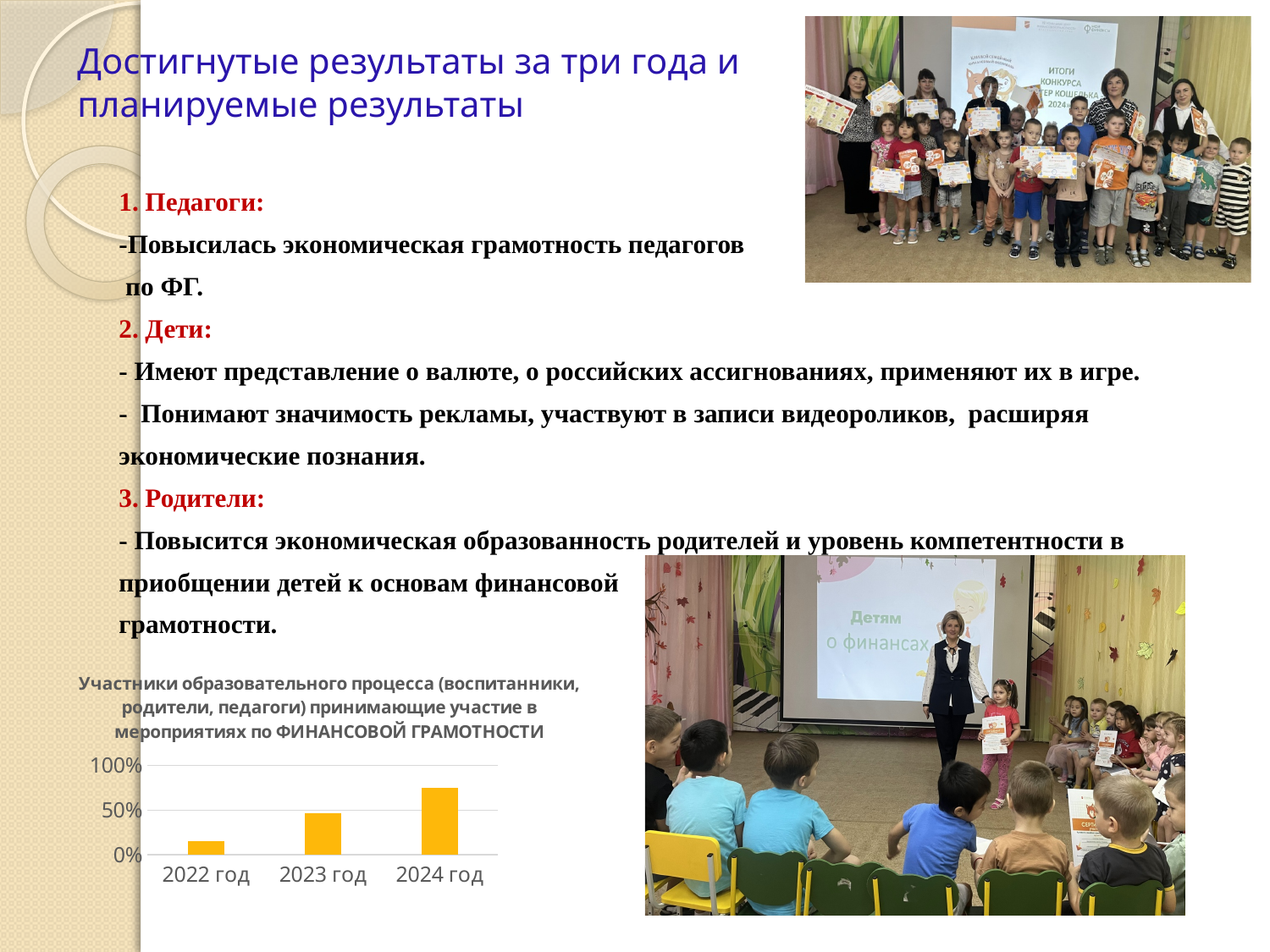
Is the value for 2022 год greater or less than 50%? less Which is larger, the value for 2023 год or the value for 2022 год? 2023 год Which year has the lowest bar in the chart? 2022 год What kind of chart is shown on the slide? bar chart Which is larger, the value for 2024 год or the value for 2023 год? 2024 год Do the values rise or fall from 2022 год to 2024 год? rise What is the highest tick value shown on the chart's vertical axis? 100% Is the value for 2024 год greater or less than 100%? less Which year has the highest bar in the chart? 2024 год What colour are the bars in the chart? yellow Is the value for 2024 год greater or less than 50%? greater How many categories (years) are shown on the x axis of the chart? 3